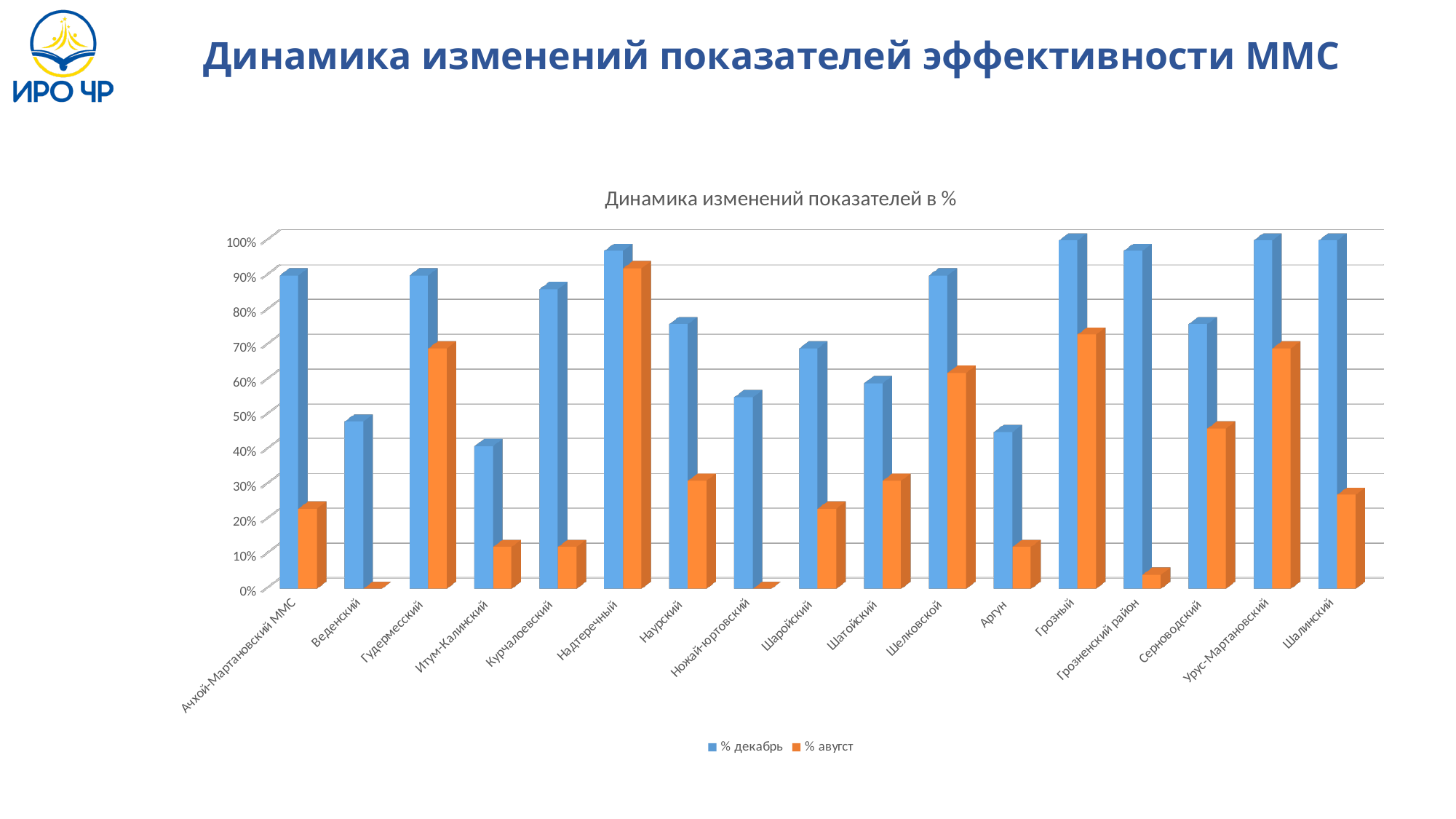
Is the value for Ачхой-Мартановский ММС in the % декабрь series greater or less than 80%? greater How many series does the legend list? 2 What is the title of the chart? Динамика изменений показателей в % Which is larger in the % авгст series: Грозный or Серноводский? Грозный What kind of chart is shown on the slide? bar chart Which series is shown in orange? % авугст Which category has the highest value for % авгст? Надтеречный How many categories are shown on the x axis? 17 Is the value for Грозненский район in the % авгст series greater or less than 10%? less Is the value for Итум-Калинский in the % декабрь series greater or less than 50%? less Which is larger in the % декабрь series: Шаройский or Шатойский? Шаройский